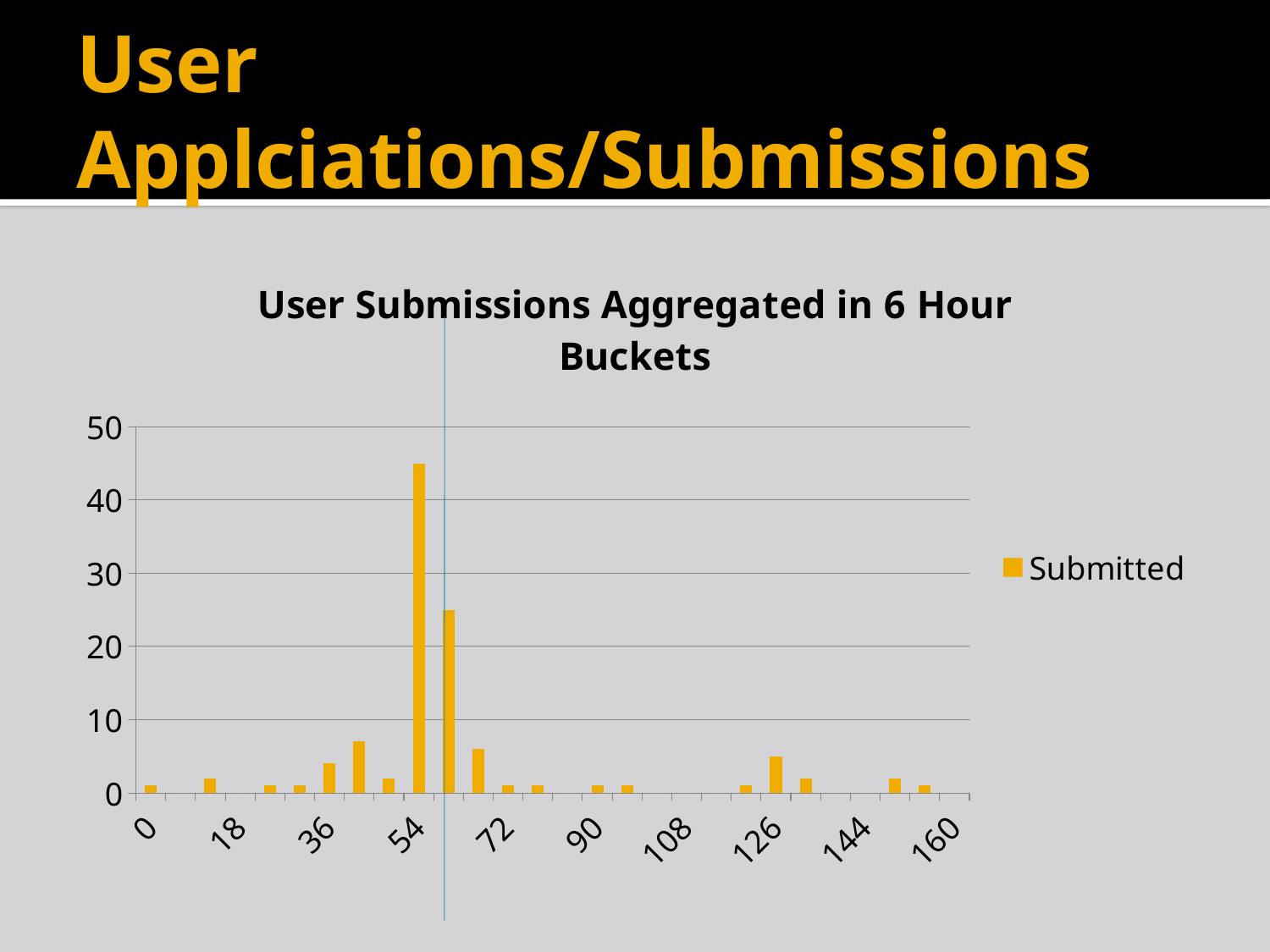
Is the value of the tallest bar (at 54) greater or less than 40? greater Is the value of the second-tallest bar (just right of 54) greater or less than 20? greater Which is larger: the bar at 54 or the bar immediately to its right? the bar at 54 Is the value of the bar at 126 greater or less than 10? less How many tick labels are shown on the x axis? 10 How many series does the legend list? 1 What is the title of the chart? User Submissions Aggregated in 6 Hour Buckets What is the name of the series shown in the legend? Submitted What kind of chart is shown on the slide? bar chart At which x-axis value is the tallest bar located? 54